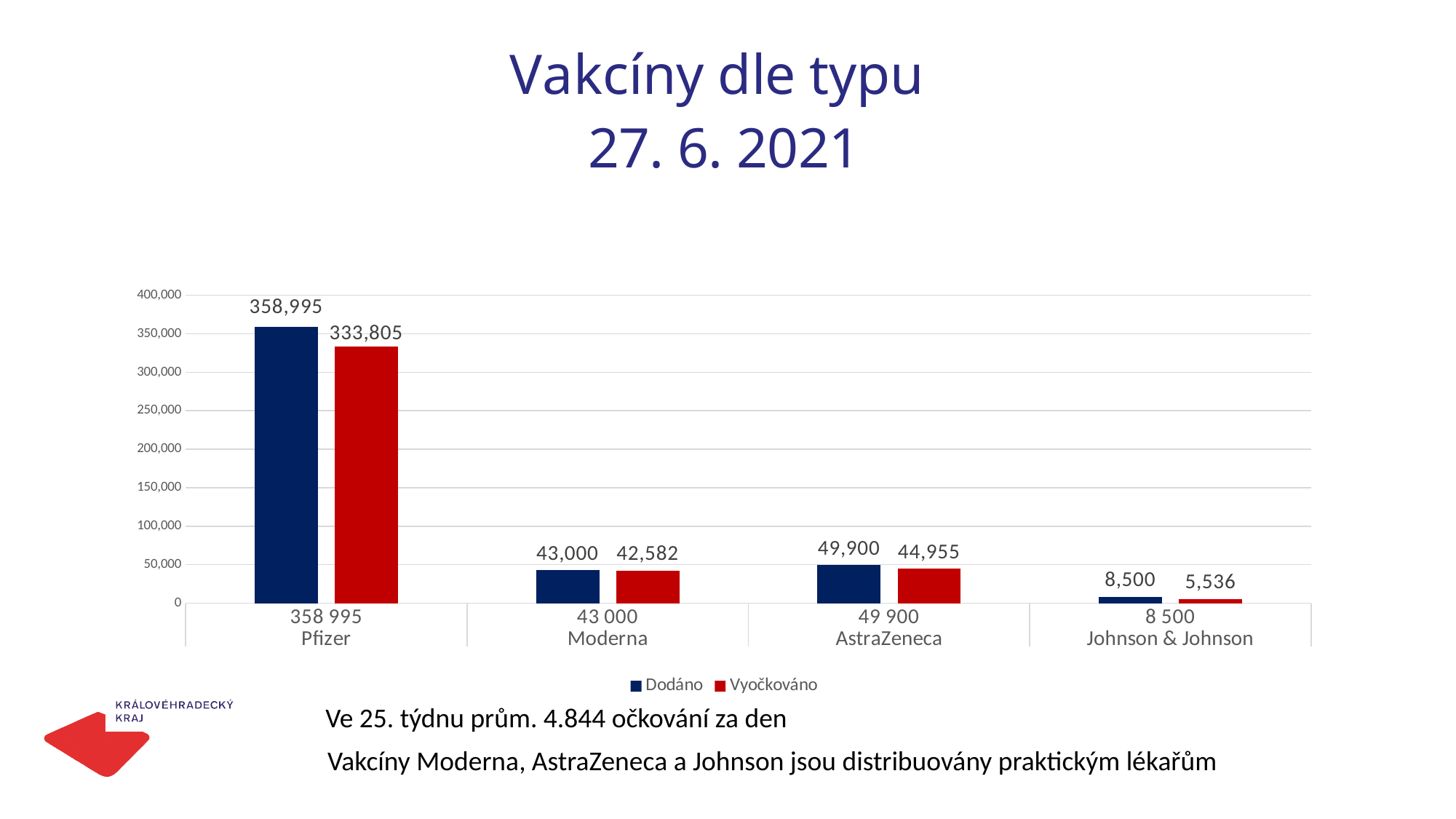
What kind of chart is shown on the slide? Bar chart What is the difference between the Dodáno and Vyočkováno values for Pfizer? 25,190 What is the Vyočkováno value for Johnson & Johnson? 5,536 Which vaccine has the lowest Vyočkováno value? Johnson & Johnson What is the Dodáno value for Pfizer? 358,995 How many series does the legend list? 2 What is the Dodáno value for Moderna? 43,000 Which is larger: the Dodáno value for AstraZeneca or the Dodáno value for Moderna? AstraZeneca How many vaccine types are shown on the x axis? 4 What is the difference between the Dodáno values for AstraZeneca and Moderna? 6,900 What is the Vyočkováno value for AstraZeneca? 44,955 Which vaccine has the highest Dodáno value? Pfizer